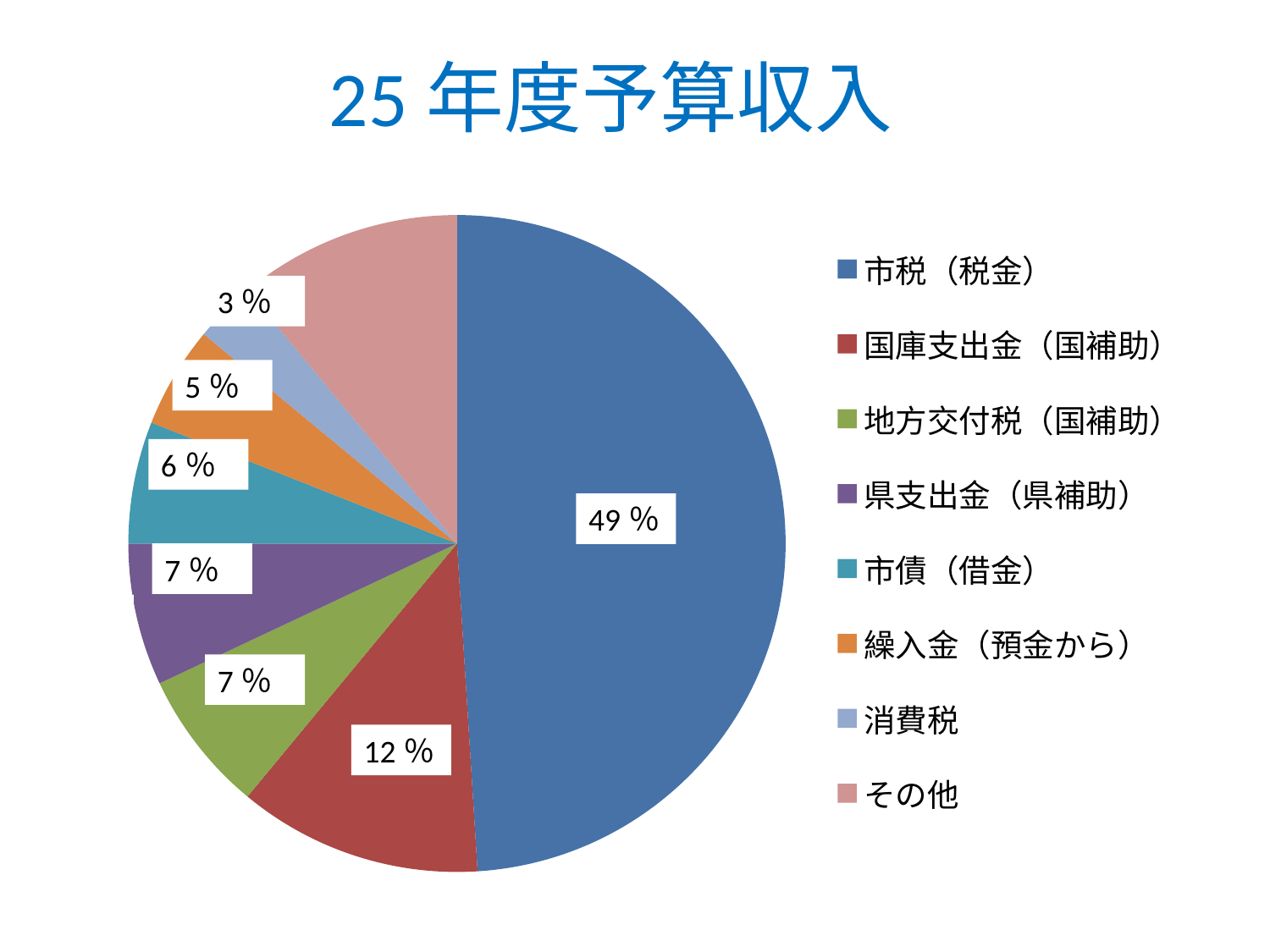
What is the value shown for 市債（借金）? 6 % How many categories does the legend list? 8 What share of the pie does 市税（税金） represent? 49 % Which is larger, the share of 市債（借金） or the share of 繰入金（預金から）? 市債（借金） Which labelled category has the smallest slice of the pie? 消費税 What is the value shown for 繰入金（預金から）? 5 % What is the title of the chart? 25 年度予算収入 What is the value shown for 国庫支出金（国補助）? 12 % What kind of chart is shown on the slide? pie chart What is the value shown for 消費税? 3 % What is the difference between the shares of 市税（税金） and 国庫支出金（国補助）? 37 % Which category has the largest slice of the pie? 市税（税金）